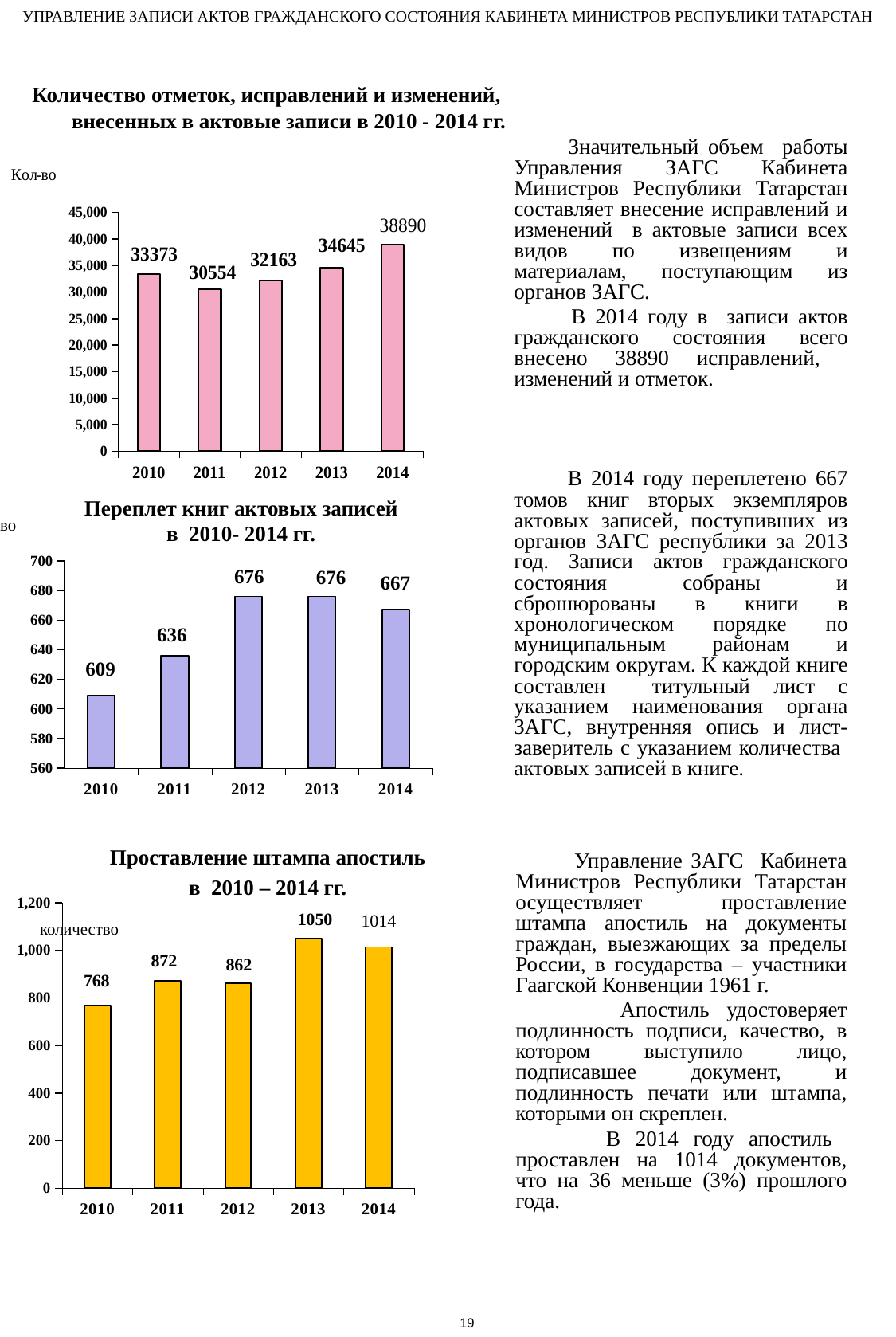
In the top chart (Количество отметок, исправлений и изменений), what is the difference between the 2014 and 2013 values? 4245 In the top chart (Количество отметок, исправлений и изменений), what is the value for 2014? 38890 In the bottom chart (Проставление штампа апостиль), what is the value for 2013? 1050 In the top chart (Количество отметок, исправлений и изменений), which year has the lowest value? 2011 In the bottom chart (Проставление штампа апостиль), what is the difference between the 2013 and 2014 values? 36 In the middle chart (Переплет книг актовых записей), what is the difference between the 2012 and 2010 values? 67 What type of chart is the bottom chart (Проставление штампа апостиль)? bar chart In the middle chart (Переплет книг актовых записей), which year has the lowest value? 2010 In the middle chart (Переплет книг актовых записей), is the value for 2014 larger or smaller than the value for 2013? smaller In the bottom chart (Проставление штампа апостиль), which year has the highest value? 2013 In the middle chart (Переплет книг актовых записей), what is the value for 2011? 636 In the top chart (Количество отметок, исправлений и изменений), how many years are shown on the x axis? 5